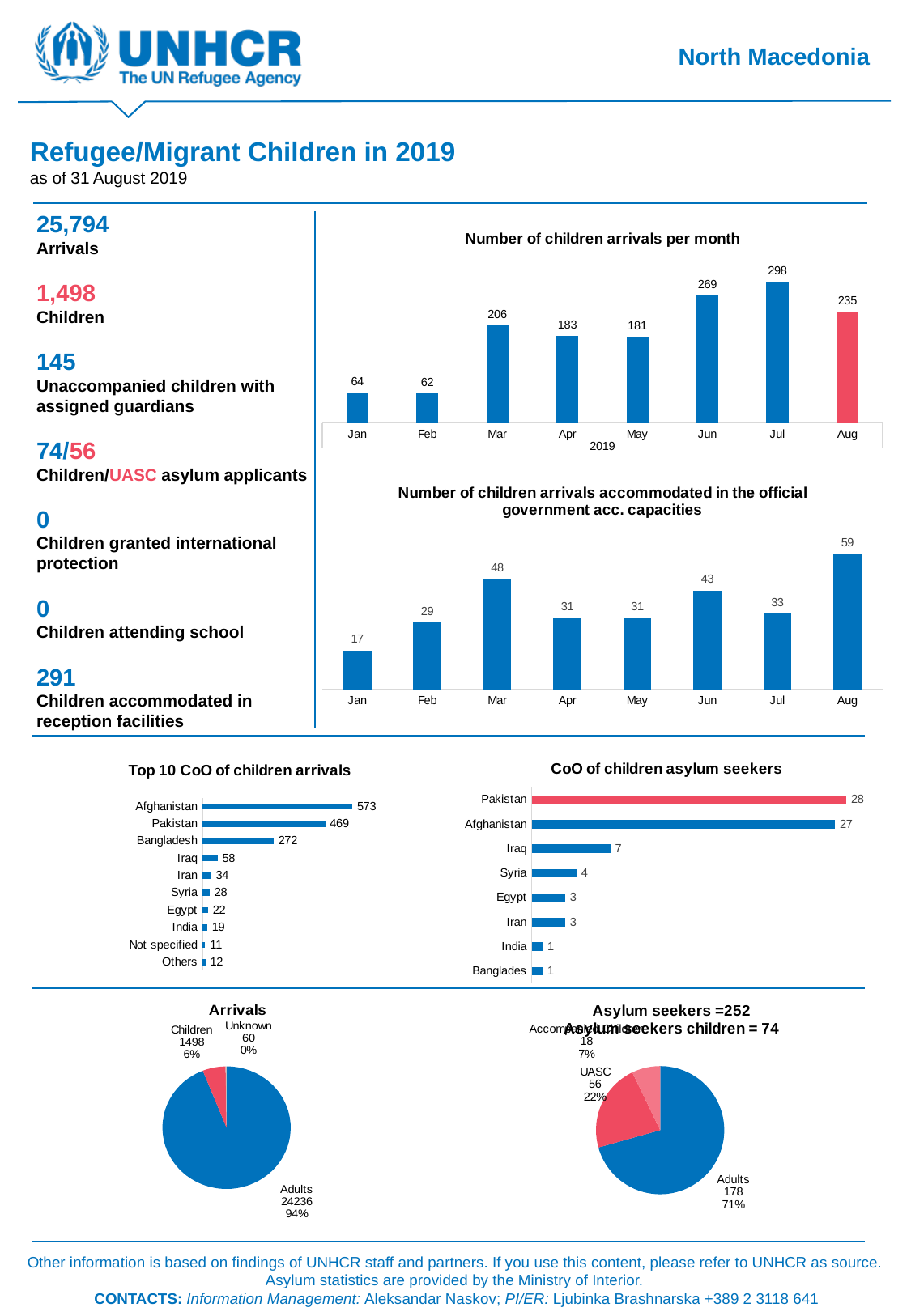
In the 'CoO of children asylum seekers' chart, what is the difference between Afghanistan and Iraq? 20 What kind of chart is the 'Top 10 CoO of children arrivals' chart? Bar chart In the 'Number of children arrivals per month' chart, what is the difference between Jun and Mar? 63 In the 'Number of children arrivals per month' chart, what is the value for Jul? 298 In the 'Number of children arrivals accommodated in the official government acc. capacities' chart, which month has the highest value? Aug In the 'Top 10 CoO of children arrivals' chart, what is the value for Bangladesh? 272 In the 'Top 10 CoO of children arrivals' chart, which is larger, Iraq or Iran? Iraq In the 'CoO of children asylum seekers' chart, what is the value for Pakistan? 28 In the 'Number of children arrivals accommodated in the official government acc. capacities' chart, how many months are plotted? 8 In the 'Number of children arrivals accommodated in the official government acc. capacities' chart, what is the value for Mar? 48 In the 'Number of children arrivals per month' chart, which month has the lowest value? Feb In the 'Arrivals' pie chart, what share of the pie is Adults? 94%